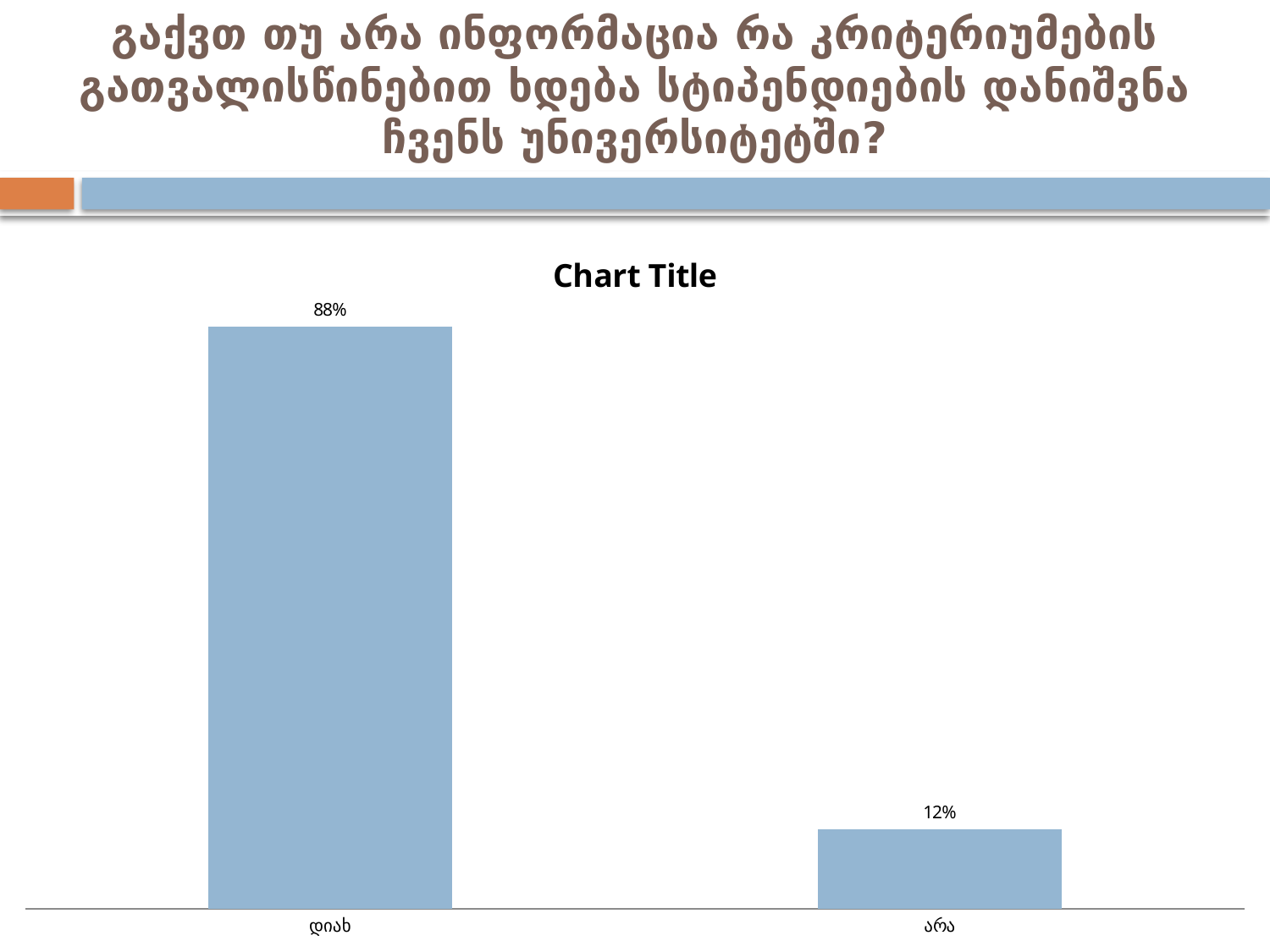
What is the value for დიახ? 88% What kind of chart is shown on the slide? bar chart What colour are the bars in the chart? light blue What is the title of the chart? Chart Title What is the difference between the values for დიახ and არა? 76% Which is larger, the value for დიახ or the value for არა? დიახ What is the total of the two values shown in the chart? 100% What is the value for არა? 12% Which category has the lowest value? არა How many categories are shown in the chart? 2 Which category has the highest value? დიახ